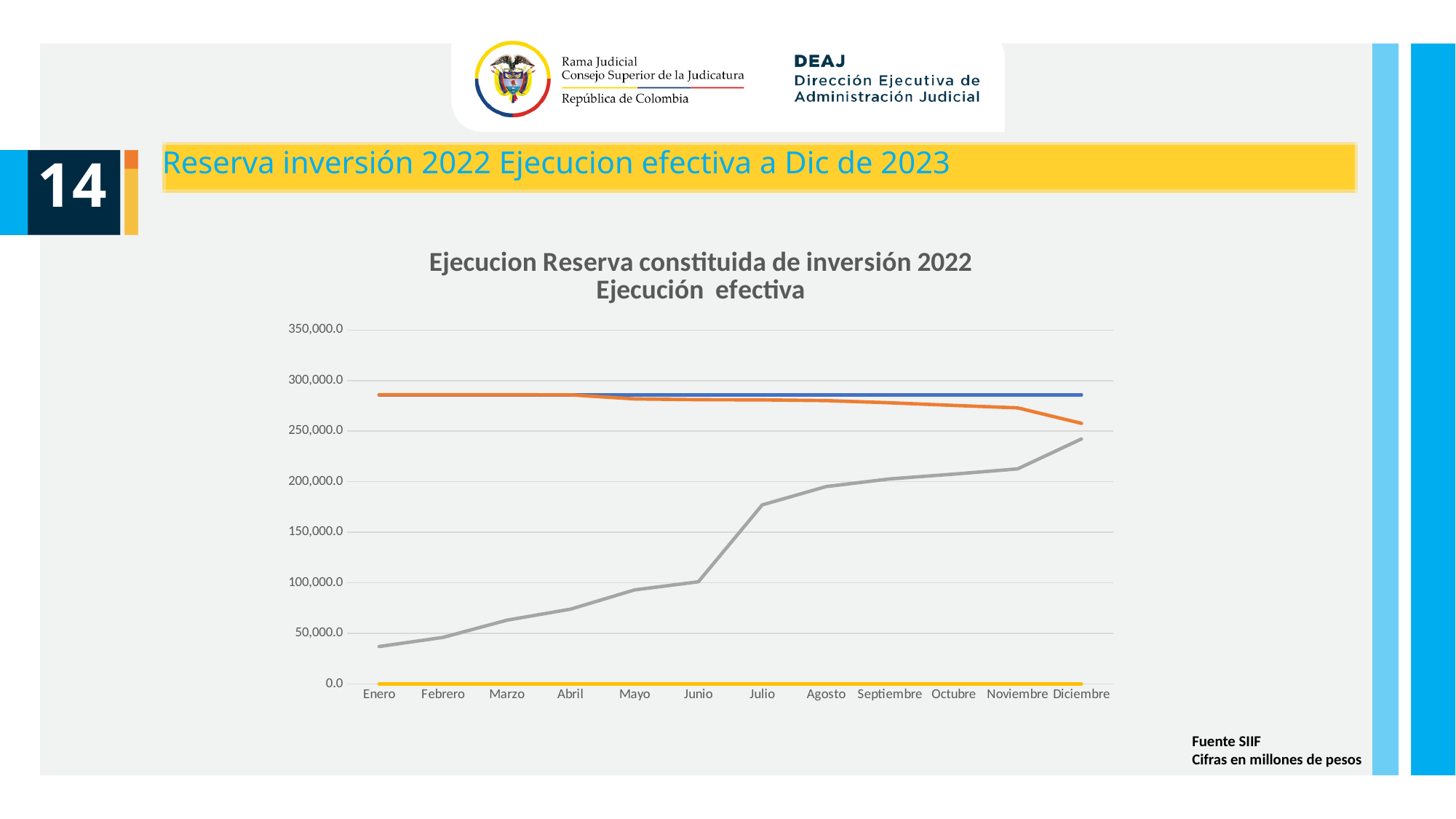
In Diciembre, which line has the higher value, the orange line or the gray line? the orange line Is the value of the blue line in Enero greater or less than 250,000.0? greater Is the value of the gray line in Enero greater or less than 50,000.0? less In which month does the gray line reach its highest value? Diciembre Is the value of the gray line in Diciembre greater or less than 200,000.0? greater Does the orange line rise or fall from Enero to Diciembre? fall What is the title of the chart? Ejecucion Reserva constituida de inversión 2022 Ejecución efectiva How many months are shown along the x axis of the chart? 12 What kind of chart is shown on the slide? line chart Does the gray line rise or fall from Enero to Diciembre? rise In Diciembre, which line has the higher value, the blue line or the gray line? the blue line